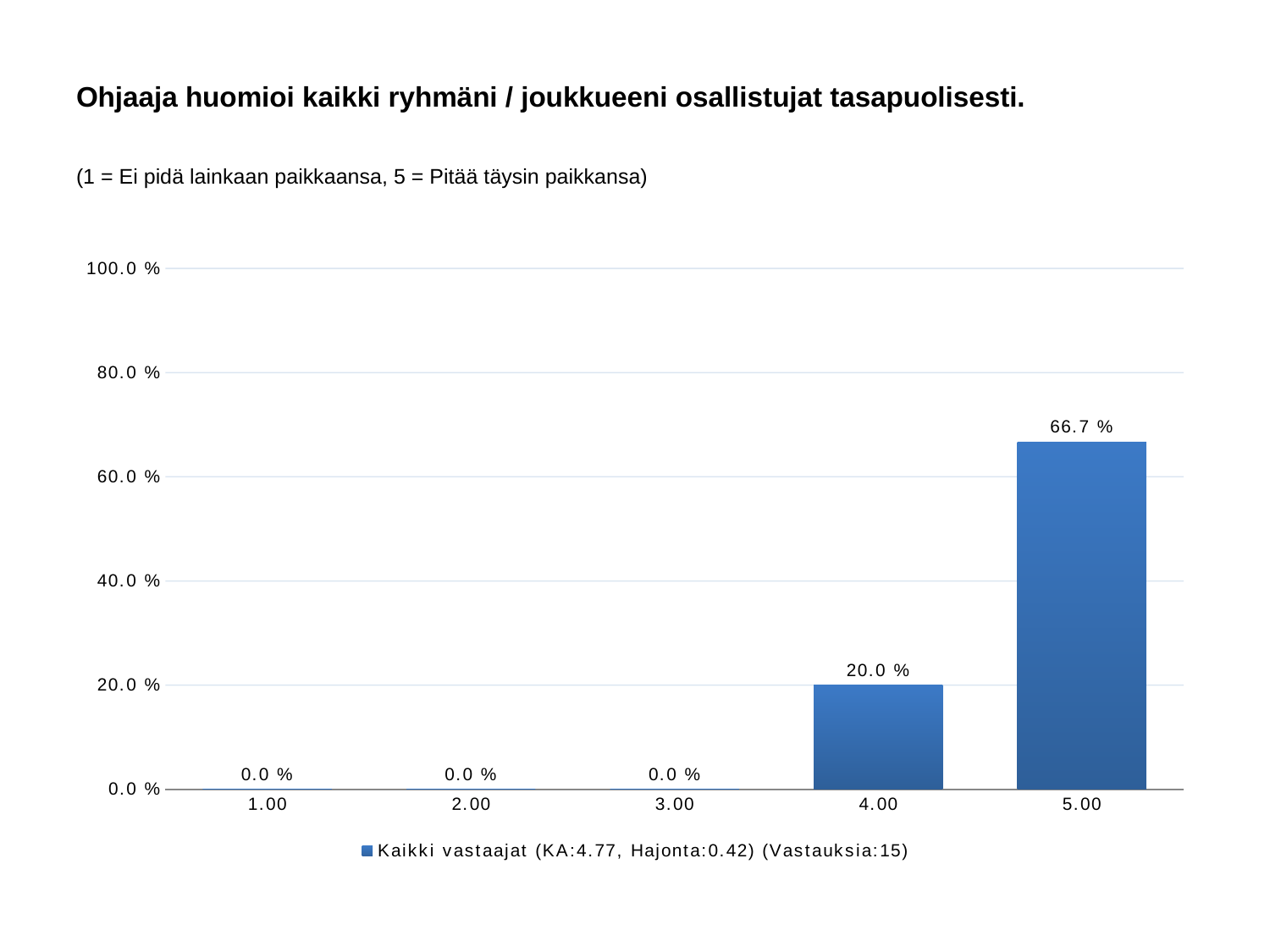
How many categories are shown on the x axis? 5 Which is larger, the value for 4.00 or the value for 5.00? 5.00 What kind of chart is shown? bar chart Is the value for 5.00 greater or less than 60.0 %? greater What is the value for category 1.00? 0.0 % What is the difference between the values for 5.00 and 4.00? 46.7 % What is the number of responses (Vastauksia) given in the legend? 15 What is the value for category 4.00? 20.0 % What is the value for category 5.00? 66.7 % How many series does the legend list? 1 Do the values rise or fall from category 3.00 to 5.00? rise Which category has the highest value? 5.00